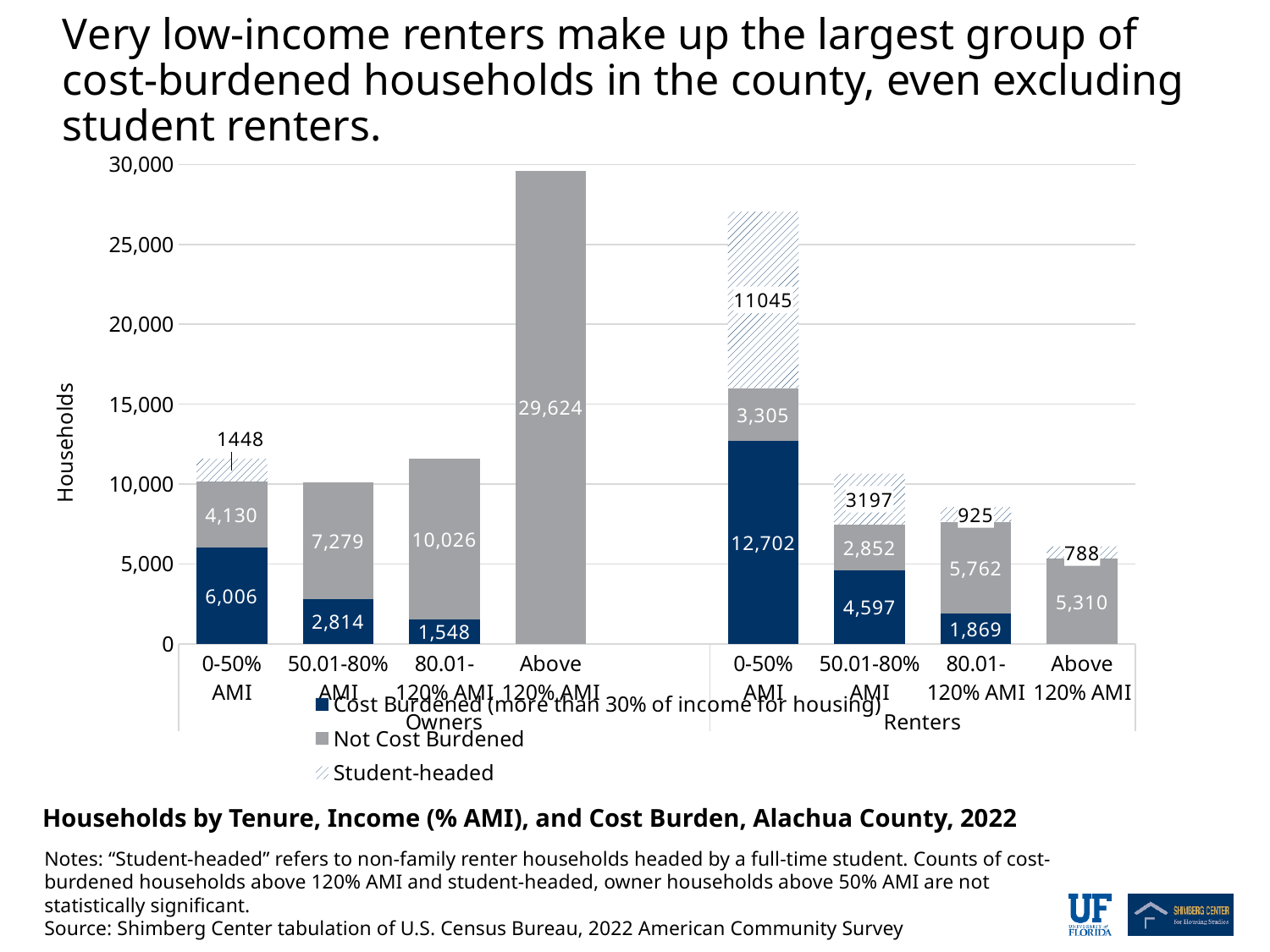
How many Student-headed households are shown for Renters with 0-50% AMI? 11045 Which has more Not Cost Burdened households: Owners with 80.01-120% AMI or Renters with 80.01-120% AMI? Owners with 80.01-120% AMI Among the groups with a Cost Burdened label, which has the lowest Cost Burdened value? Owners, 80.01-120% AMI How many more Cost Burdened households are there among Renters with 0-50% AMI than among Owners with 0-50% AMI? 6,696 Which tenure and income group has the highest number of Cost Burdened households? Renters, 0-50% AMI How many income-group bars are plotted in total across Owners and Renters? 8 What is the Not Cost Burdened value for Owners Above 120% AMI? 29,624 What is the number of Cost Burdened households for Renters with 0-50% AMI? 12,702 What is the total height of the stacked bar for Renters with 50.01-80% AMI? 10,646 How many series does the legend list? 3 Is the total for the Renters 0-50% AMI bar greater or less than 25,000? greater What kind of chart is shown on the slide? Stacked bar chart